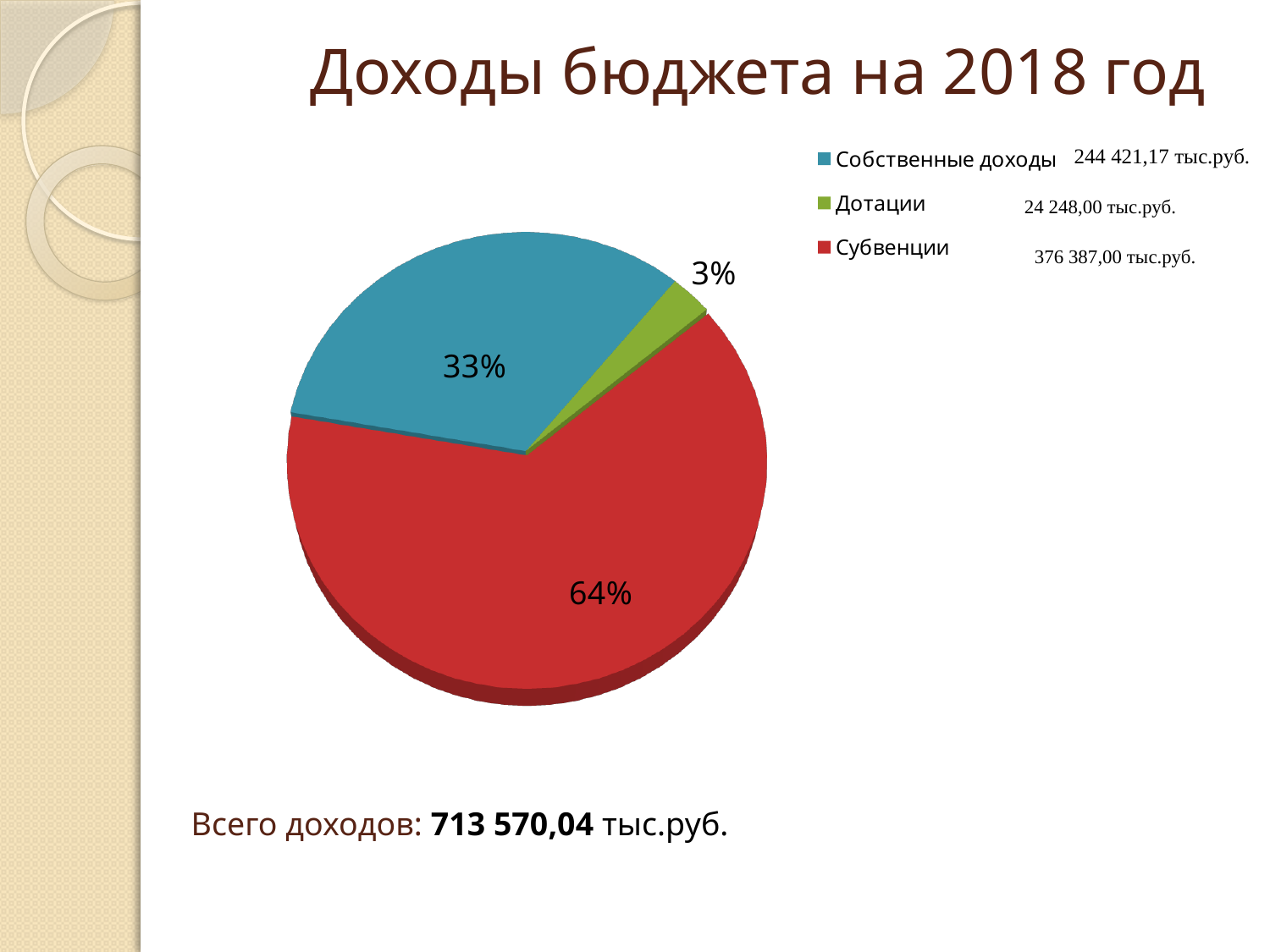
What share of the pie does Субвенции take? 64% What is the title of the chart on the slide? Доходы бюджета на 2018 год Which category has the smallest slice of the pie? Дотации Which category has the largest slice of the pie? Субвенции What is the difference in percentage points between the Субвенции slice and the Собственные доходы slice? 31% How many slices does the pie chart have? 3 What kind of chart is shown on the slide? Pie chart What share of the pie does Собственные доходы take? 33% What colour is the Субвенции slice in the pie chart? Red How many entries does the legend list? 3 Which is larger, the share for Собственные доходы or the share for Дотации? Собственные доходы What share of the pie does Дотации take? 3%